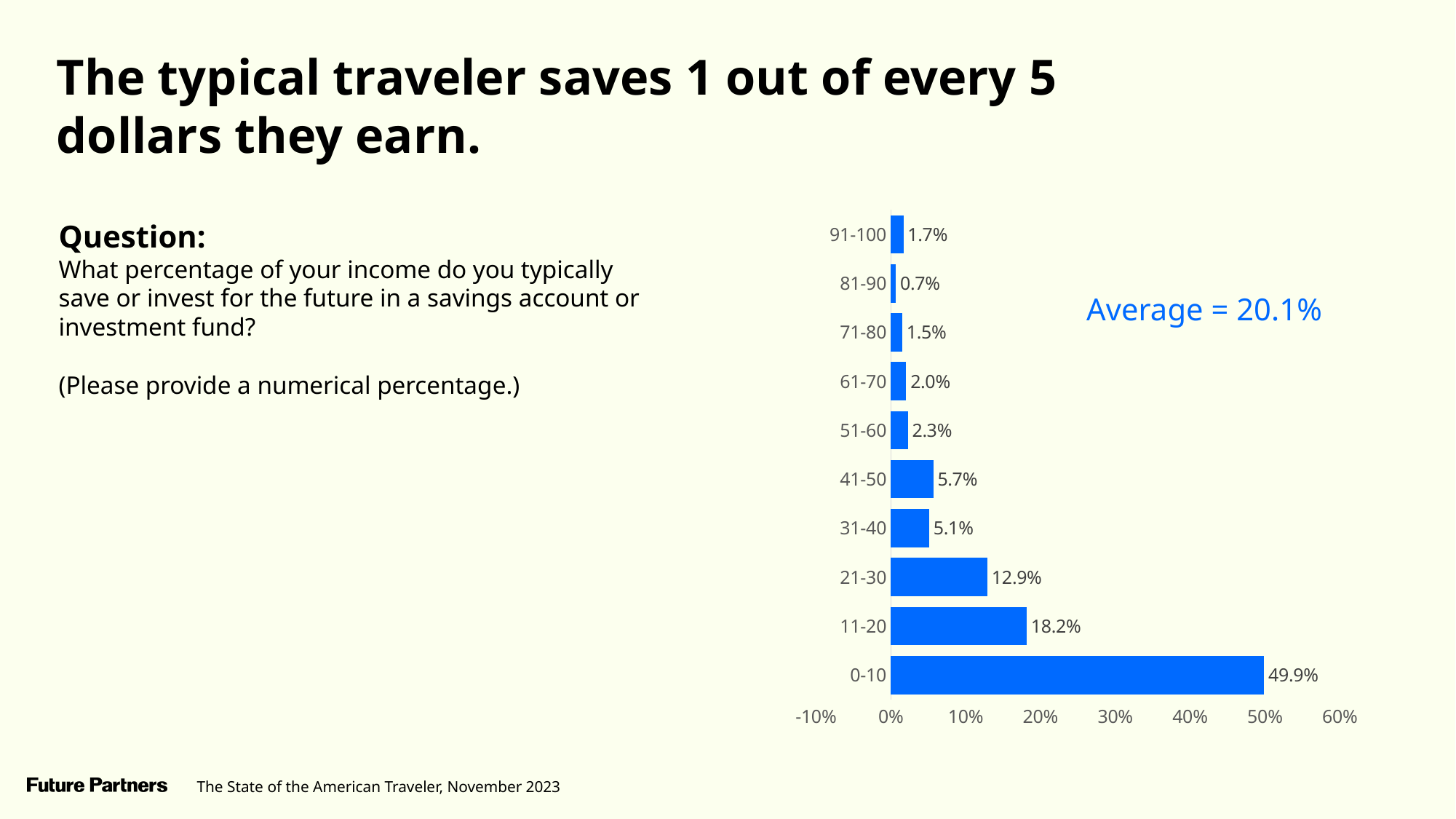
Which category has the lowest value? 81-90 What kind of chart is shown on the slide? bar chart What is the value for the 81-90 category? 0.7% What is the value for the 11-20 category? 18.2% What is the difference between the values for 0-10 and 11-20? 31.7% What average value is annotated on the chart? 20.1% Which is larger, the value for 41-50 or the value for 31-40? 41-50 How many categories are shown in the chart? 10 Is the value for 21-30 greater or less than 10%? greater What is the value for the 41-50 category? 5.7% What percentage of respondents save 0-10% of their income? 49.9% Which category has the highest value? 0-10